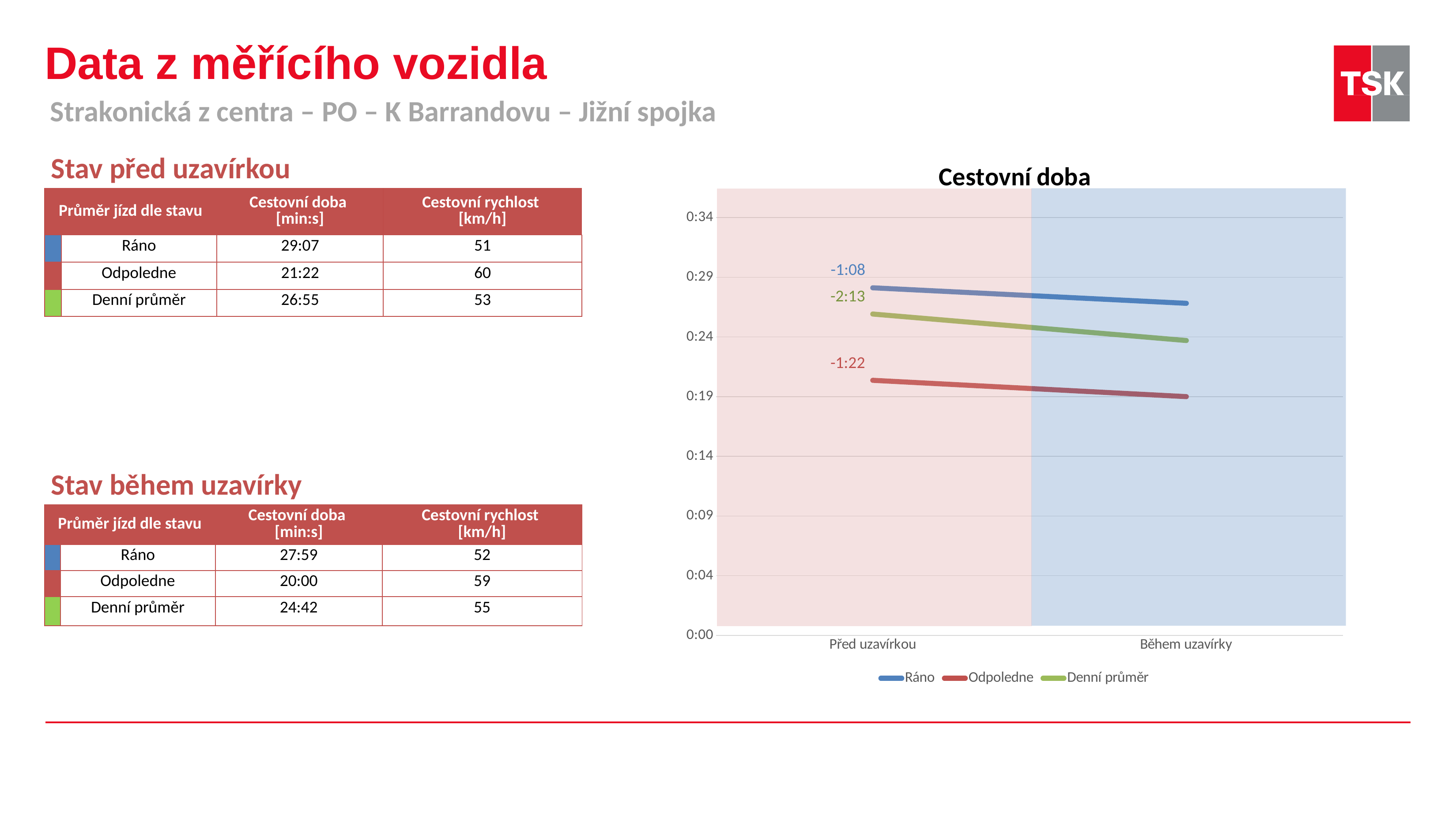
In the "Cestovní doba" chart, what change is labelled on the Denní průměr line? -2:13 In the "Cestovní doba" chart, is the Odpoledne value for "Před uzavírkou" greater or less than 0:19? greater In the "Cestovní doba" chart, what change is labelled on the Odpoledne line? -1:22 In the "Cestovní doba" chart, do the lines rise or fall from "Před uzavírkou" to "Během uzavírky"? fall In the "Cestovní doba" chart, which series has the highest travel time? Ráno How many categories are shown on the x axis of the "Cestovní doba" chart? 2 In the "Cestovní doba" chart, which series is drawn in green? Denní průměr In the "Cestovní doba" chart, which series has the lowest travel time? Odpoledne What kind of chart is the "Cestovní doba" chart? line chart In the "Cestovní doba" chart, what change is labelled on the Ráno line? -1:08 How many series does the legend of the "Cestovní doba" chart list? 3 In the "Cestovní doba" chart, is the Ráno value for "Během uzavírky" greater or less than 0:29? less